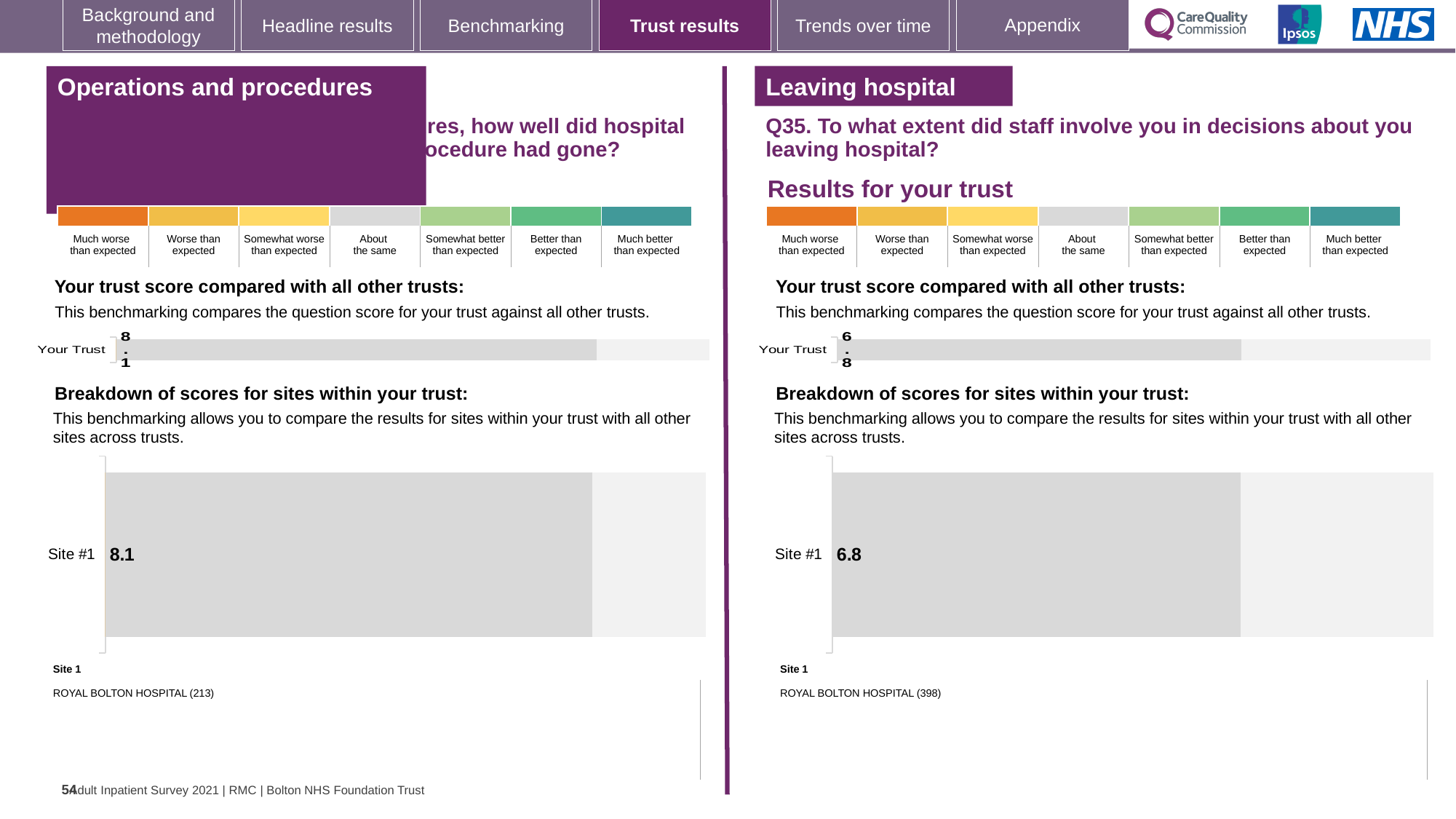
What kind of chart is used for the 'Breakdown of scores for sites within your trust' in the Leaving hospital section? Bar chart In the Operations and procedures 'Breakdown of scores for sites within your trust' chart, what is the score for Site #1? 8.1 What is the difference between the Site #1 score in the Operations and procedures breakdown chart and the Site #1 score in the Leaving hospital breakdown chart? 1.3 In the Leaving hospital section, what number appears in brackets after ROYAL BOLTON HOSPITAL for Site 1? 398 How many bars are plotted in the Operations and procedures 'Your trust score compared with all other trusts' chart? 1 In the Leaving hospital 'Breakdown of scores for sites within your trust' chart, what is the score for Site #1? 6.8 In the Leaving hospital section, what is the score shown for Your Trust in the 'Your trust score compared with all other trusts' chart? 6.8 In the Operations and procedures section, which hospital is listed as Site 1 below the breakdown chart? ROYAL BOLTON HOSPITAL (213) How many sites are shown in the Leaving hospital 'Breakdown of scores for sites within your trust' chart? 1 In the Operations and procedures section, what is the score shown for Your Trust in the 'Your trust score compared with all other trusts' chart? 8.1 Which is larger: the Your Trust score in the Operations and procedures section or the Your Trust score in the Leaving hospital section? Operations and procedures